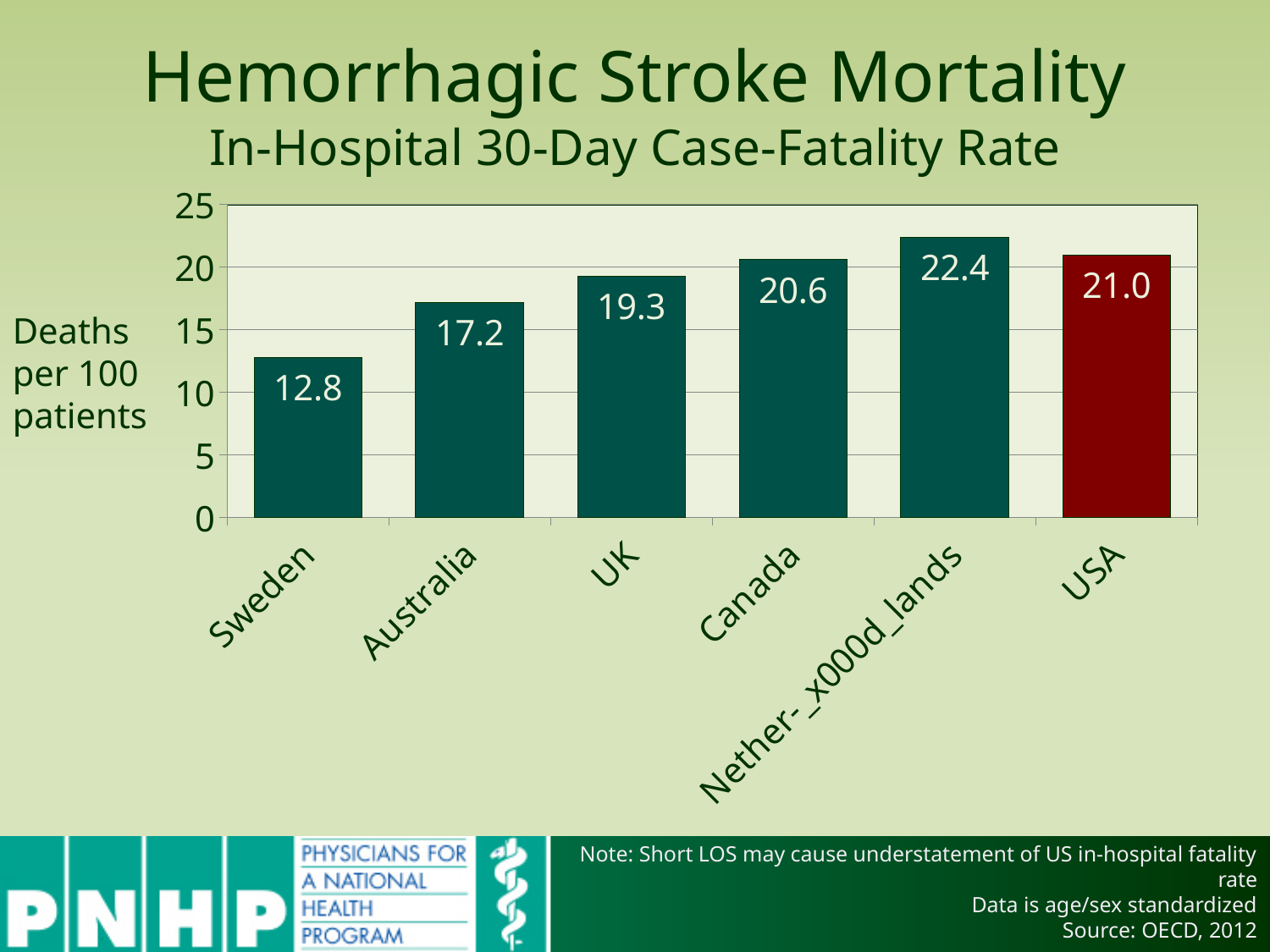
Which country has the lowest in-hospital 30-day case-fatality rate on the chart? Sweden How many countries are shown on the chart? 6 Which has a higher value, Australia or Canada? Canada What is the hemorrhagic stroke mortality rate for Sweden? 12.8 What kind of chart is shown on the slide? Bar chart What is the value shown for the USA bar? 21.0 What is the difference between the values for the Netherlands and the USA? 1.4 What is the difference between the values for the USA and Sweden? 8.2 What is the value shown for Canada? 20.6 What is the value shown for the UK? 19.3 Which country has the highest in-hospital 30-day case-fatality rate on the chart? Netherlands Which bar is coloured differently (dark red) from the others? USA